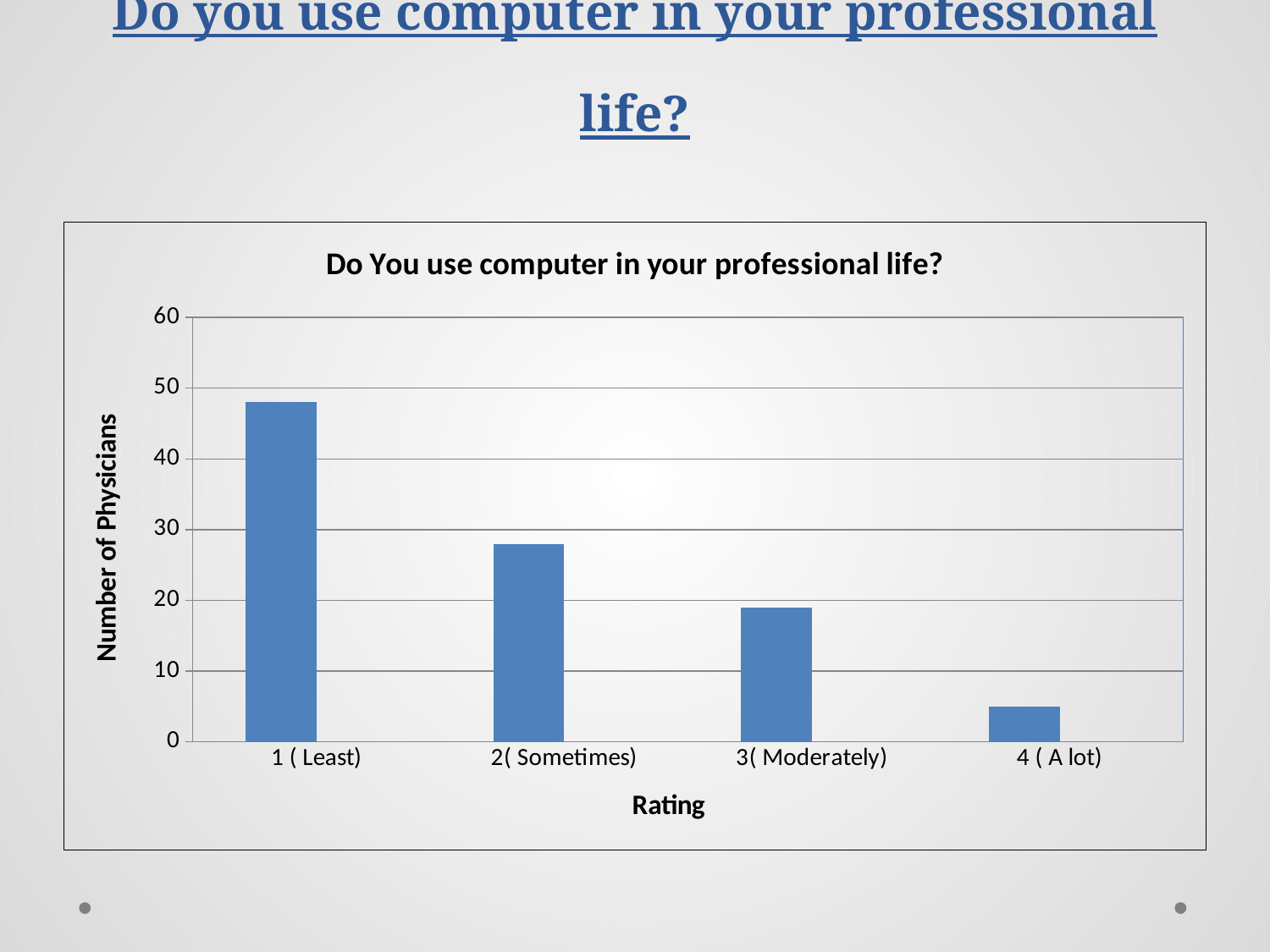
What kind of chart is shown on the slide? bar chart Which rating category has the highest number of physicians? 1 ( Least) Which has more physicians, 2( Sometimes) or 3( Moderately)? 2( Sometimes) Is the value for 4 ( A lot) greater or less than 10? less What is the title of the chart? Do You use computer in your professional life? Do the values rise or fall as the rating goes from 1 ( Least) to 4 ( A lot)? fall How many rating categories are shown on the x axis? 4 Is the value for 3( Moderately) greater or less than 10? greater Is the value for 1 ( Least) greater or less than 40? greater What is the label of the vertical axis? Number of Physicians Which rating category has the lowest number of physicians? 4 ( A lot)